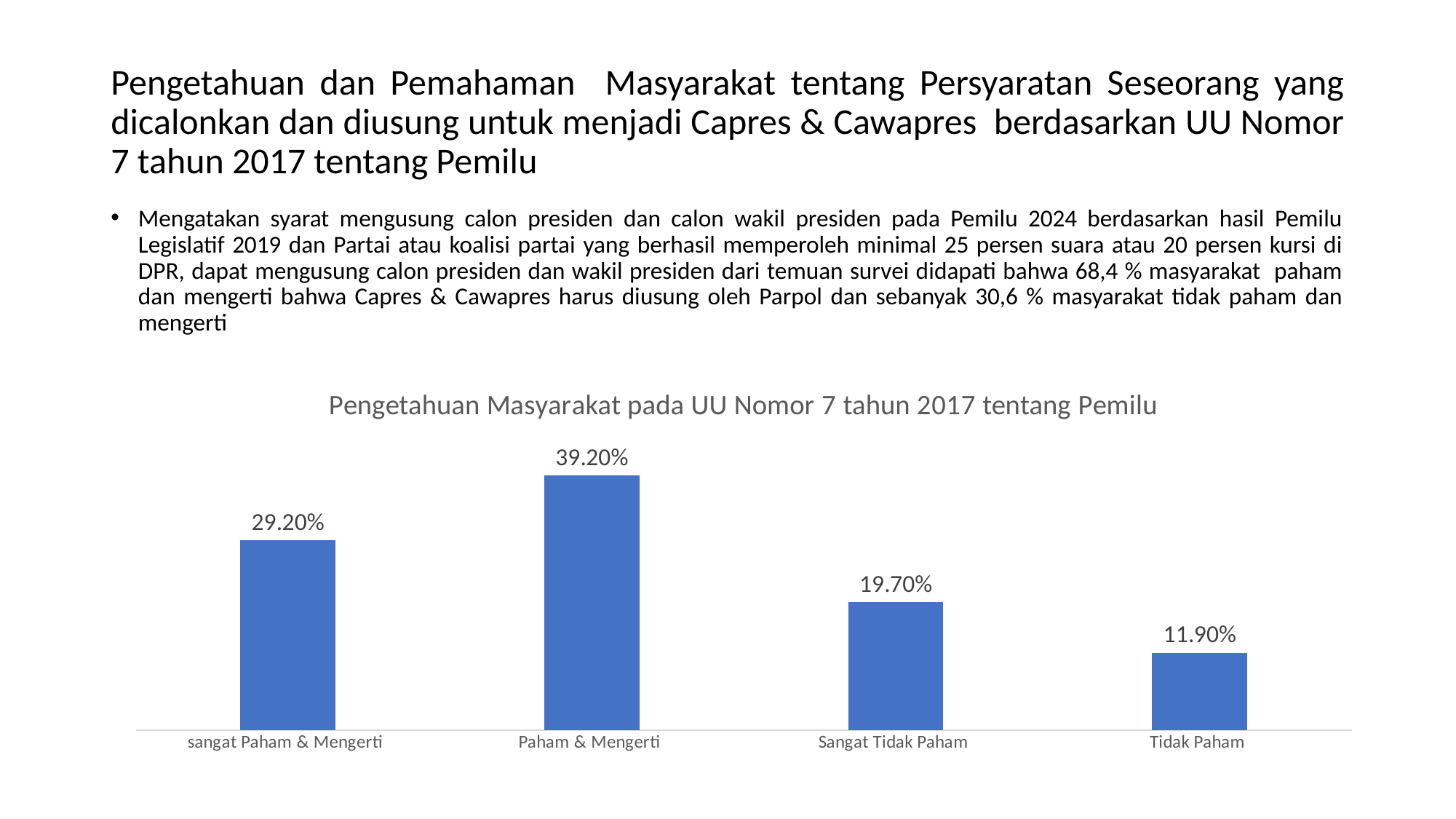
Which category has the lowest value? Tidak Paham What is the value for Paham & Mengerti? 39.20% Which category has the highest value? Paham & Mengerti What kind of chart is shown on the slide? Bar chart What is the difference between the values for Paham & Mengerti and sangat Paham & Mengerti? 10.00% What is the value for Tidak Paham? 11.90% What is the value for Sangat Tidak Paham? 19.70% What is the title of the chart? Pengetahuan Masyarakat pada UU Nomor 7 tahun 2017 tentang Pemilu How many categories are shown in the chart? 4 What is the difference between the values for Sangat Tidak Paham and Tidak Paham? 7.80% Which is larger, the value for sangat Paham & Mengerti or the value for Sangat Tidak Paham? sangat Paham & Mengerti What is the value for sangat Paham & Mengerti? 29.20%